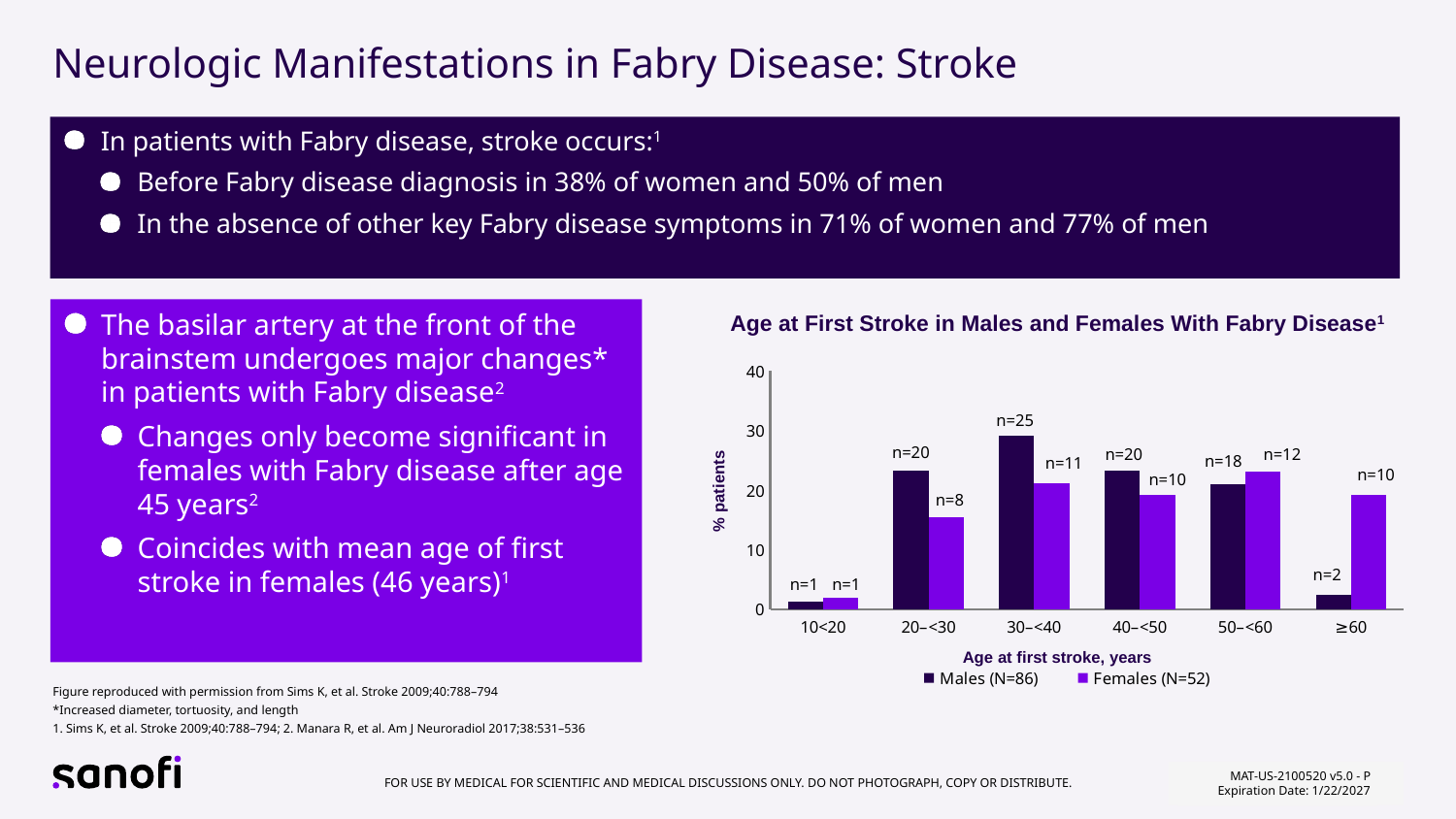
What is the difference between the n values labelled for Males and Females in the 30–<40 age group? 14 Which age group has the highest Males bar? 30–<40 In the 40–<50 age group, which bar is taller, Males or Females? Males According to the legend, what is the N for Males? N=86 What is the n value labelled on the Females bar for the 50–<60 age group? n=12 Is the value for Females in the 20–<30 age group greater or less than 20? less What kind of chart is shown on the slide? bar chart What is the n value labelled on the Males bar for the 30–<40 age group? n=25 Which age group has the lowest Females bar? 10<20 How many age categories are shown on the x axis of the chart? 6 How many series does the legend of the chart list? 2 Is the value for Males in the 30–<40 age group greater or less than 20? greater